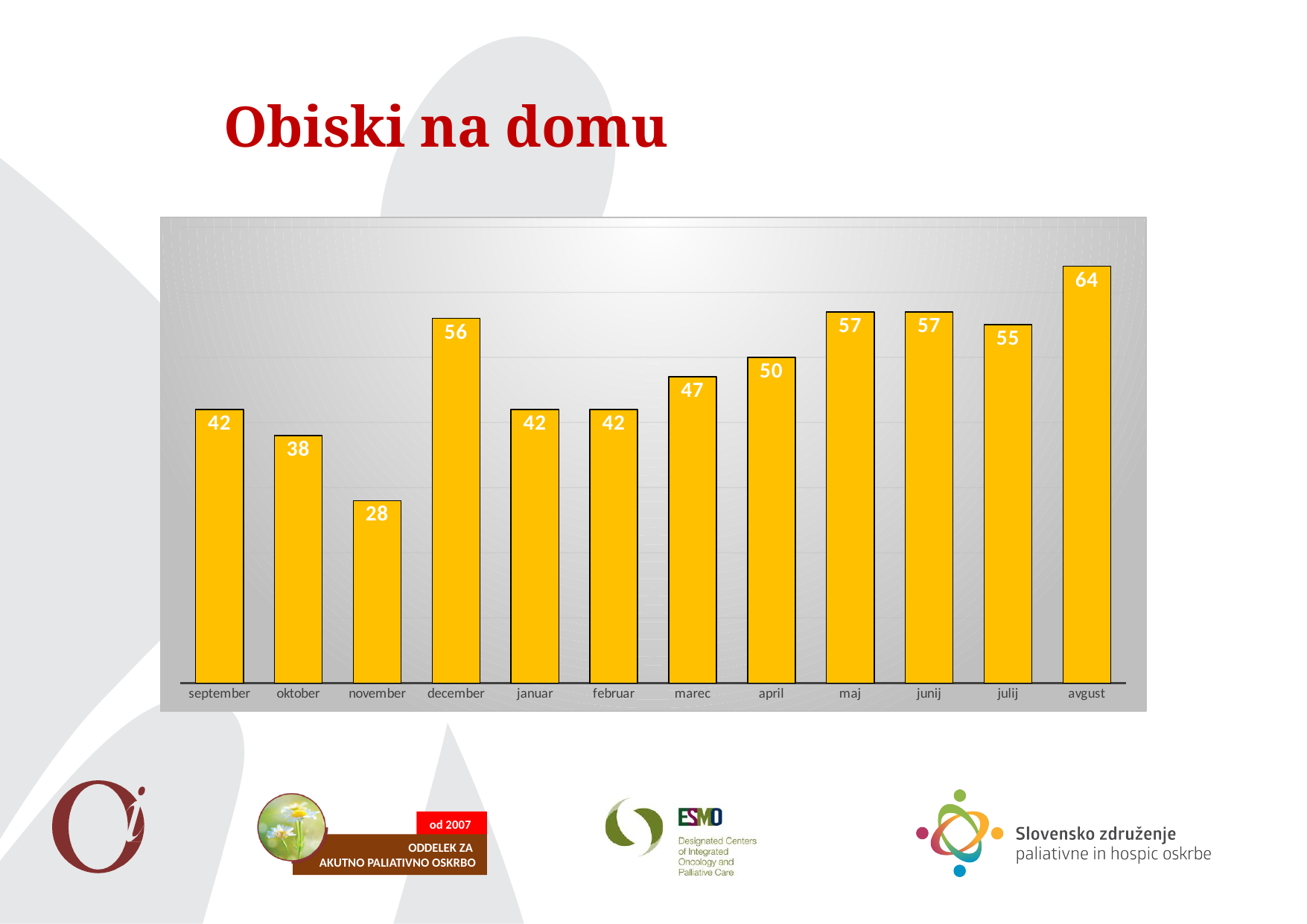
What is the value for november? 28 How many months are shown on the x axis? 12 Which month has the highest value? avgust What is the title of the slide? Obiski na domu What is the difference between the values for december and oktober? 18 Do the values generally rise or fall from januar to avgust? rise Which is larger, the value for april or the value for julij? julij What is the difference between the values for avgust and november? 36 What kind of chart is shown on the slide? bar chart What is the value for marec? 47 Which month has the lowest value? november What is the value for december? 56